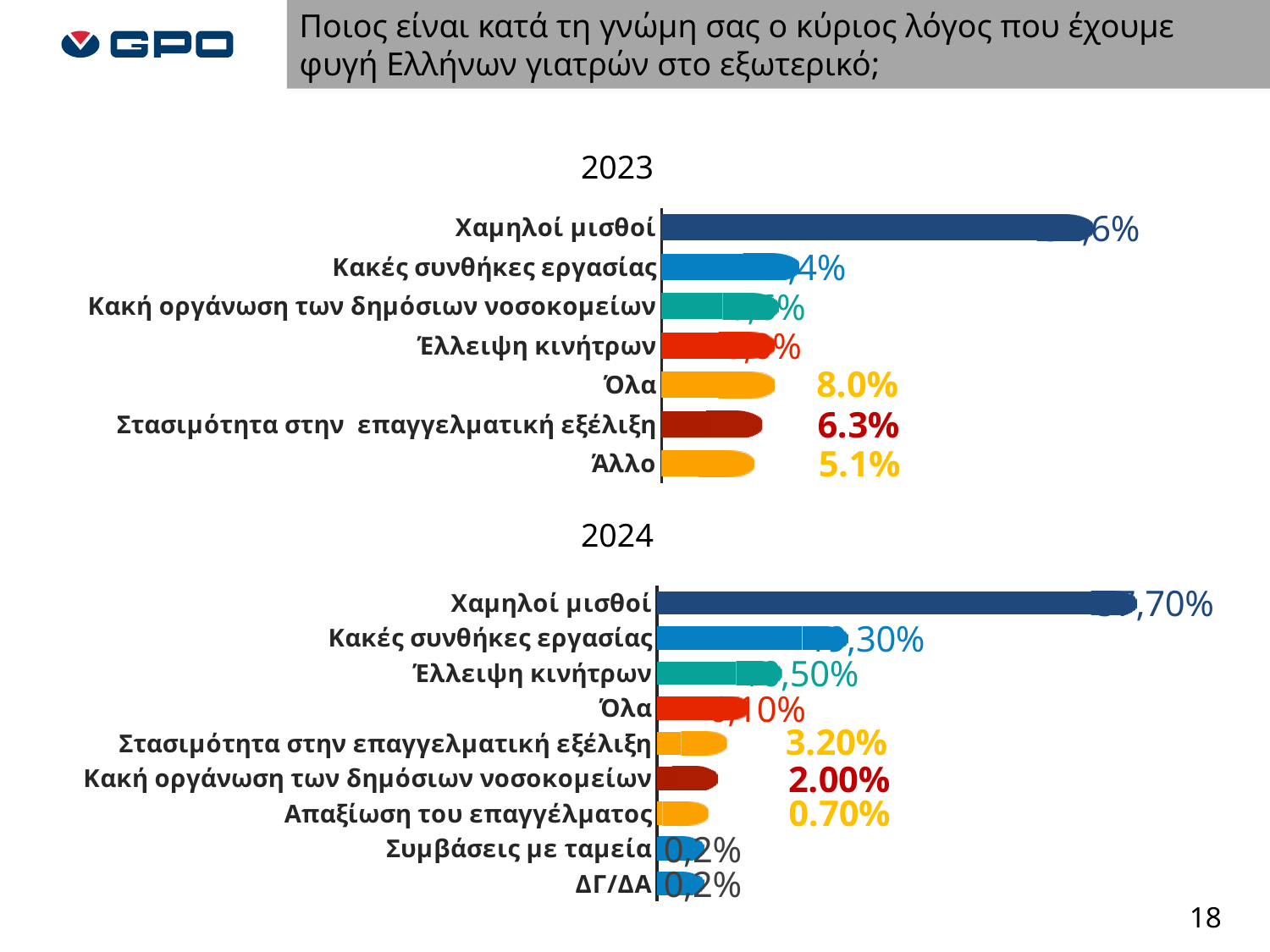
In the 2023 chart, which category has the lowest value? Άλλο In the 2023 chart, which category has the highest value? Χαμηλοί μισθοί In the 2024 chart, what is the value for Στασιμότητα στην επαγγελματική εξέλιξη? 3.20% In the 2024 chart, what is the value for Απαξίωση του επαγγέλματος? 0.70% In the 2024 chart, what is the value for Κακή οργάνωση των δημόσιων νοσοκομείων? 2.00% In the 2023 chart, what is the value for Στασιμότητα στην επαγγελματική εξέλιξη? 6.3% How many categories does the 2024 chart show? 9 In the 2023 chart, what is the difference between the values for Όλα and Άλλο? 2.9% In the 2023 chart, what is the value for Άλλο? 5.1% In the 2024 chart, which is larger: Στασιμότητα στην επαγγελματική εξέλιξη or Κακή οργάνωση των δημόσιων νοσοκομείων? Στασιμότητα στην επαγγελματική εξέλιξη In the 2023 chart, what is the value for Όλα? 8.0% In the 2024 chart, which category has the highest value? Χαμηλοί μισθοί